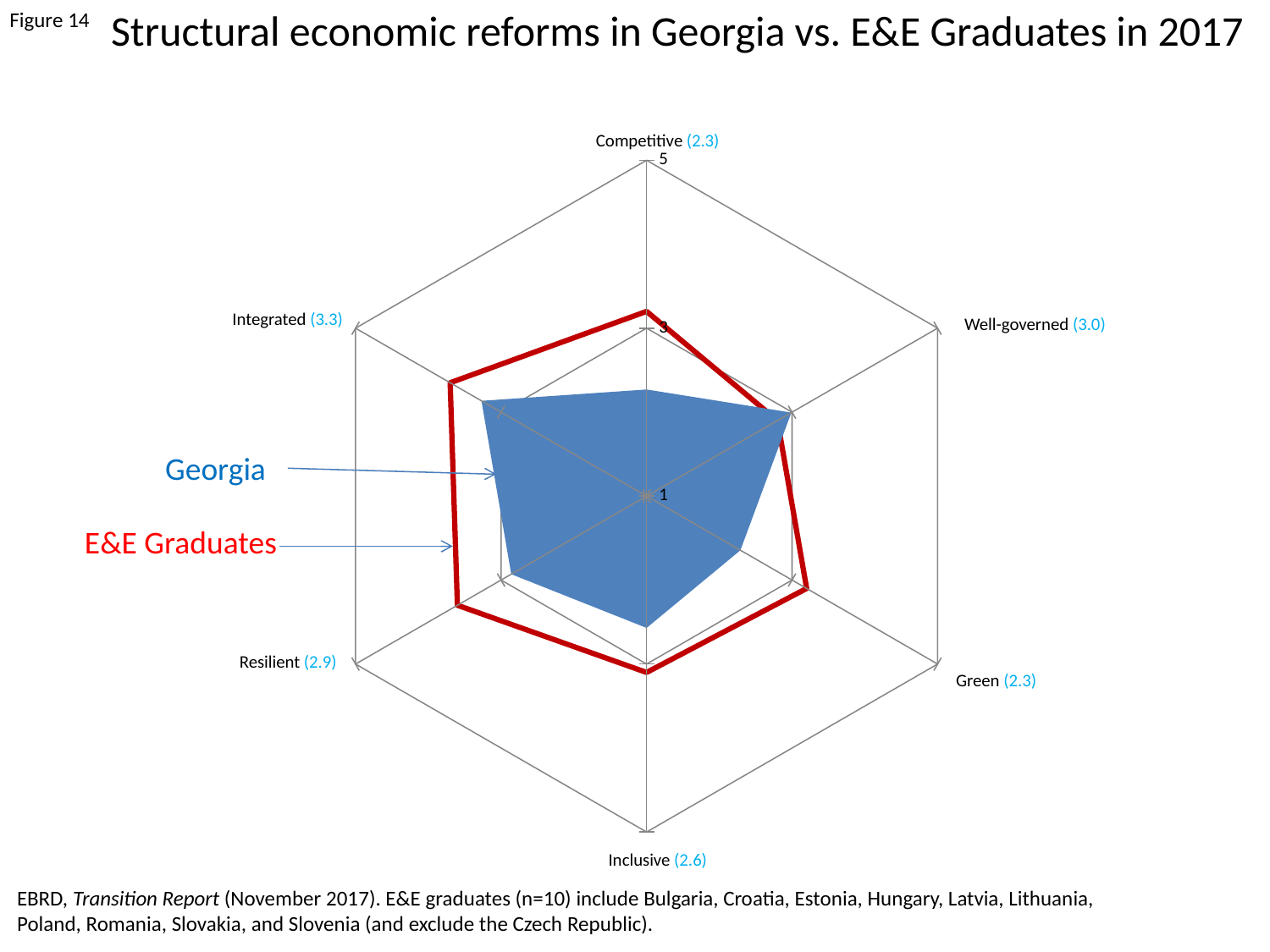
For Georgia, which is higher: Well-governed or Inclusive? Well-governed Is the E&E Graduates value for Integrated greater or less than 3? greater How many series does the chart show? 2 What is Georgia's value for Well-governed? 3.0 How many dimensions (axes) does the radar chart have? 6 Which series is drawn as the red outline? E&E Graduates What is Georgia's value for Inclusive? 2.6 On which dimension does Georgia score highest? Integrated What type of chart is shown on the slide? Radar chart On the Competitive dimension, which series has the higher value: Georgia or E&E Graduates? E&E Graduates What is the difference between Georgia's Integrated and Resilient scores? 0.4 What is Georgia's value for Integrated? 3.3